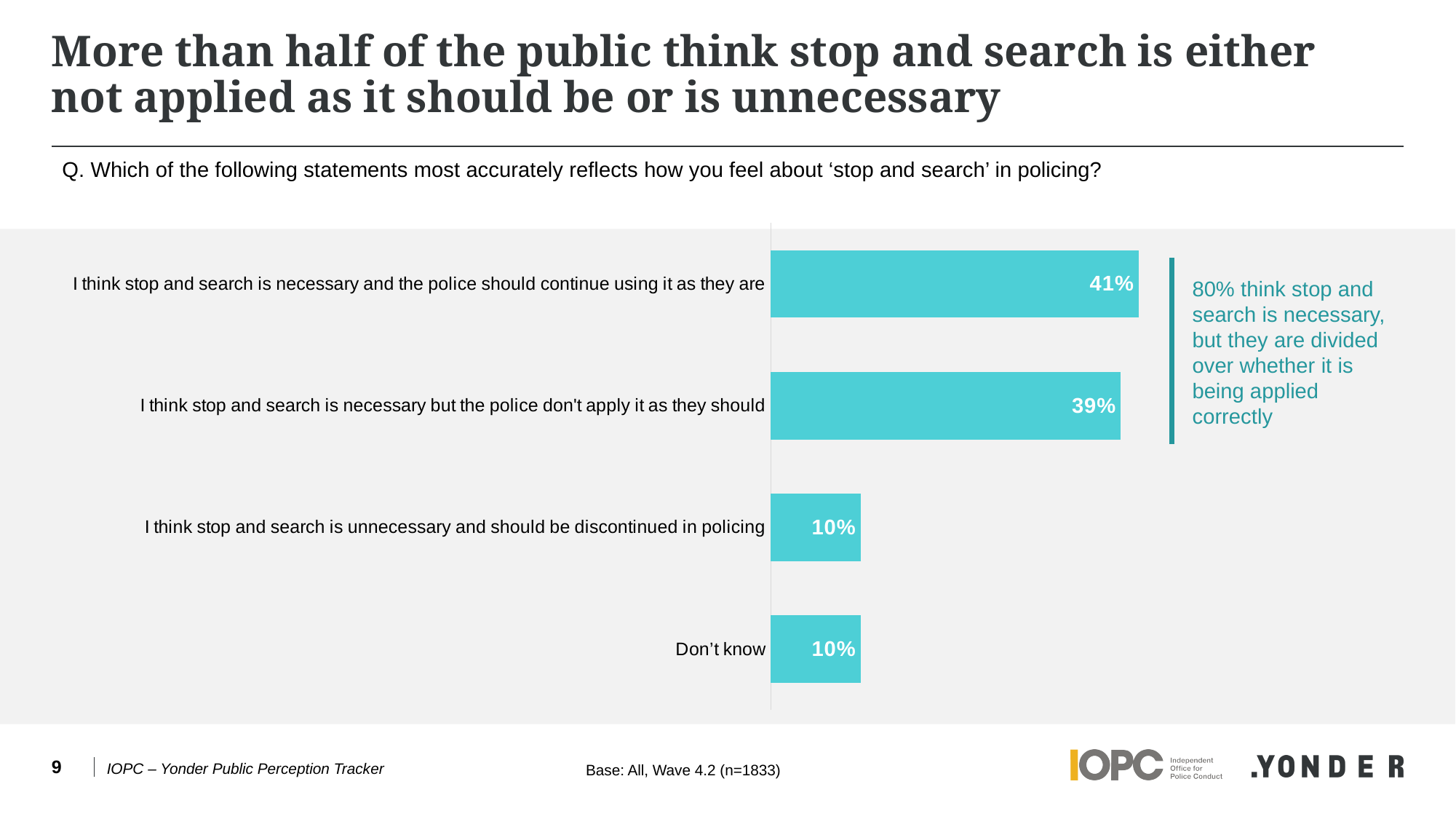
What is the combined percentage of the two responses that say stop and search is necessary? 80% What is the difference in percentage points between those who think stop and search is necessary and should continue as it is and those who think it is necessary but not applied as it should be? 2 percentage points What percentage of respondents think stop and search is necessary and the police should continue using it as they are? 41% What type of chart is shown on the slide? Bar chart What is the base (sample size) stated for the chart? All, Wave 4.2 (n=1833) What percentage of respondents answered 'Don't know'? 10% Which is larger: the share who think stop and search is necessary but not applied as it should be, or the share who think it is unnecessary and should be discontinued? Necessary but the police don't apply it as they should How many response categories are shown in the chart? 4 Which statement has the highest percentage of respondents? I think stop and search is necessary and the police should continue using it as they are What is the difference in percentage points between the 'necessary and should continue as they are' response and the 'unnecessary and should be discontinued' response? 31 percentage points What percentage of respondents think stop and search is unnecessary and should be discontinued in policing? 10% What percentage of respondents think stop and search is necessary but the police don't apply it as they should? 39%